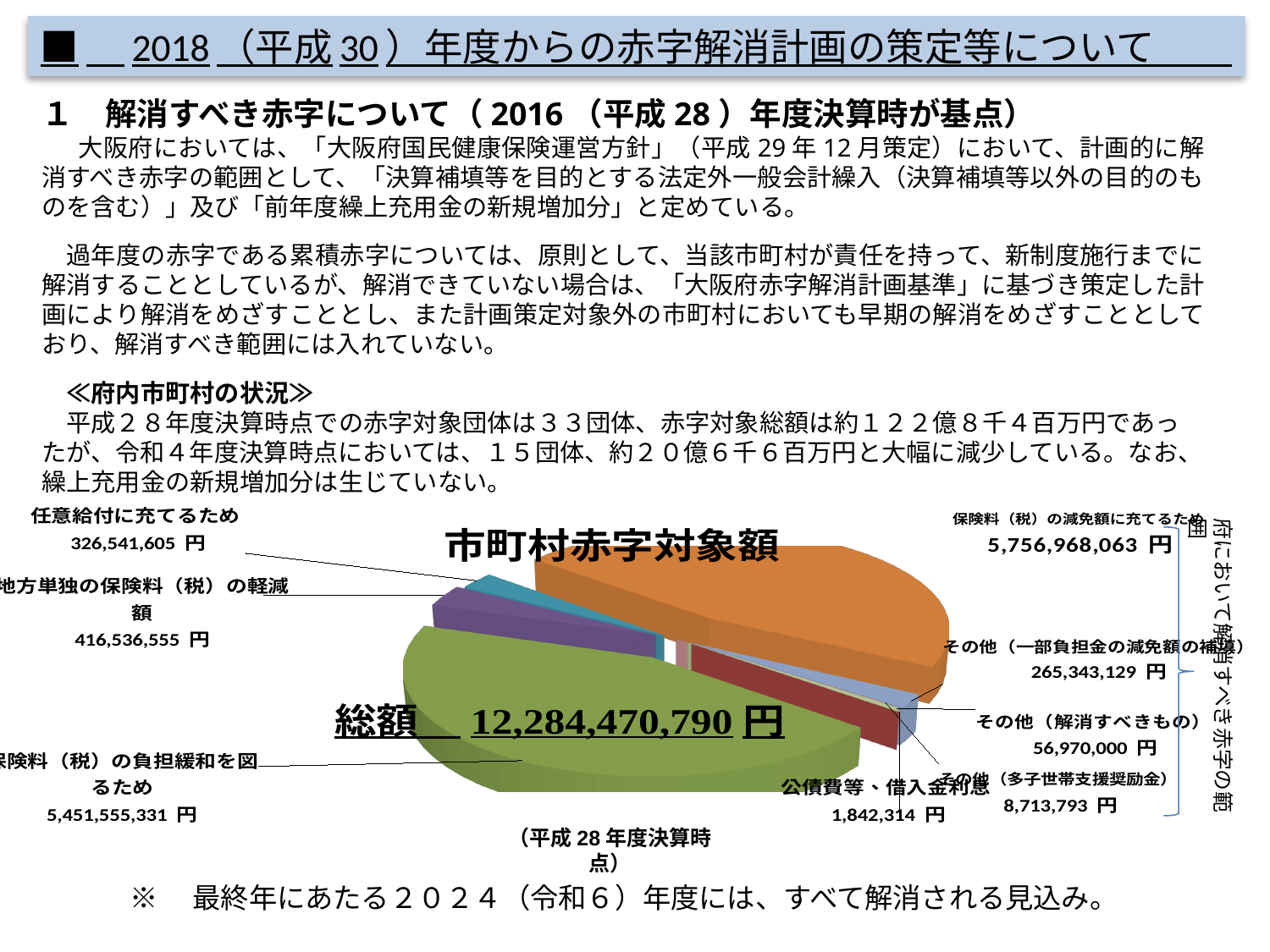
What is the total amount (総額) shown for the pie chart? 12,284,470,790 円 Which category has the smallest value in the pie chart? 公債費等、借入金利息 What kind of chart is shown on the slide? pie chart Which category has the largest value in the pie chart? 保険料（税）の減免額に充てるため How many slices does the pie chart have? 8 What is the difference between 保険料（税）の減免額に充てるため and 保険料（税）の負担緩和を図るため? 305,412,732 円 What is the value for 任意給付に充てるため? 326,541,605 円 Which is larger: 任意給付に充てるため or 地方単独の保険料（税）の軽減額? 地方単独の保険料（税）の軽減額 What is the value for 保険料（税）の減免額に充てるため? 5,756,968,063 円 What is the difference between 地方単独の保険料（税）の軽減額 and 任意給付に充てるため? 89,994,950 円 What is the title of the pie chart? 市町村赤字対象額 What is the value for 公債費等、借入金利息? 1,842,314 円